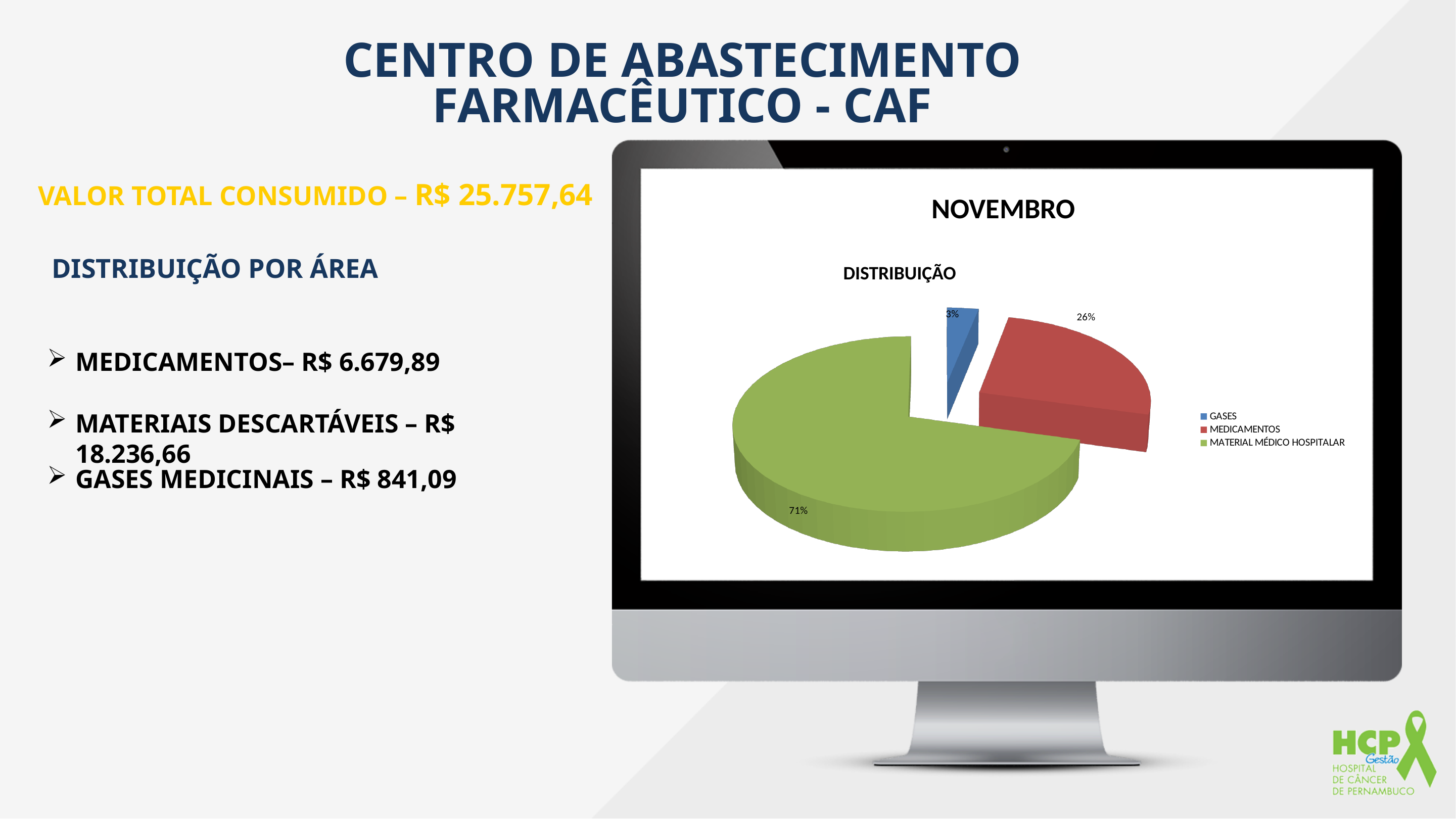
What kind of chart is shown on the slide? Pie chart What share of the pie does MATERIAL MÉDICO HOSPITALAR represent? 71% How many entries does the chart legend list? 3 What is the difference in percentage points between the MEDICAMENTOS slice and the GASES slice? 23 What share of the pie does GASES represent? 3% What is the difference in percentage points between the MATERIAL MÉDICO HOSPITALAR slice and the MEDICAMENTOS slice? 45 What colour is the MEDICAMENTOS slice in the pie chart? Red Which category has the largest slice of the pie? MATERIAL MÉDICO HOSPITALAR How many slices does the pie chart have? 3 Which slice is larger, MEDICAMENTOS or GASES? MEDICAMENTOS Which category has the smallest slice of the pie? GASES What share of the pie does MEDICAMENTOS represent? 26%